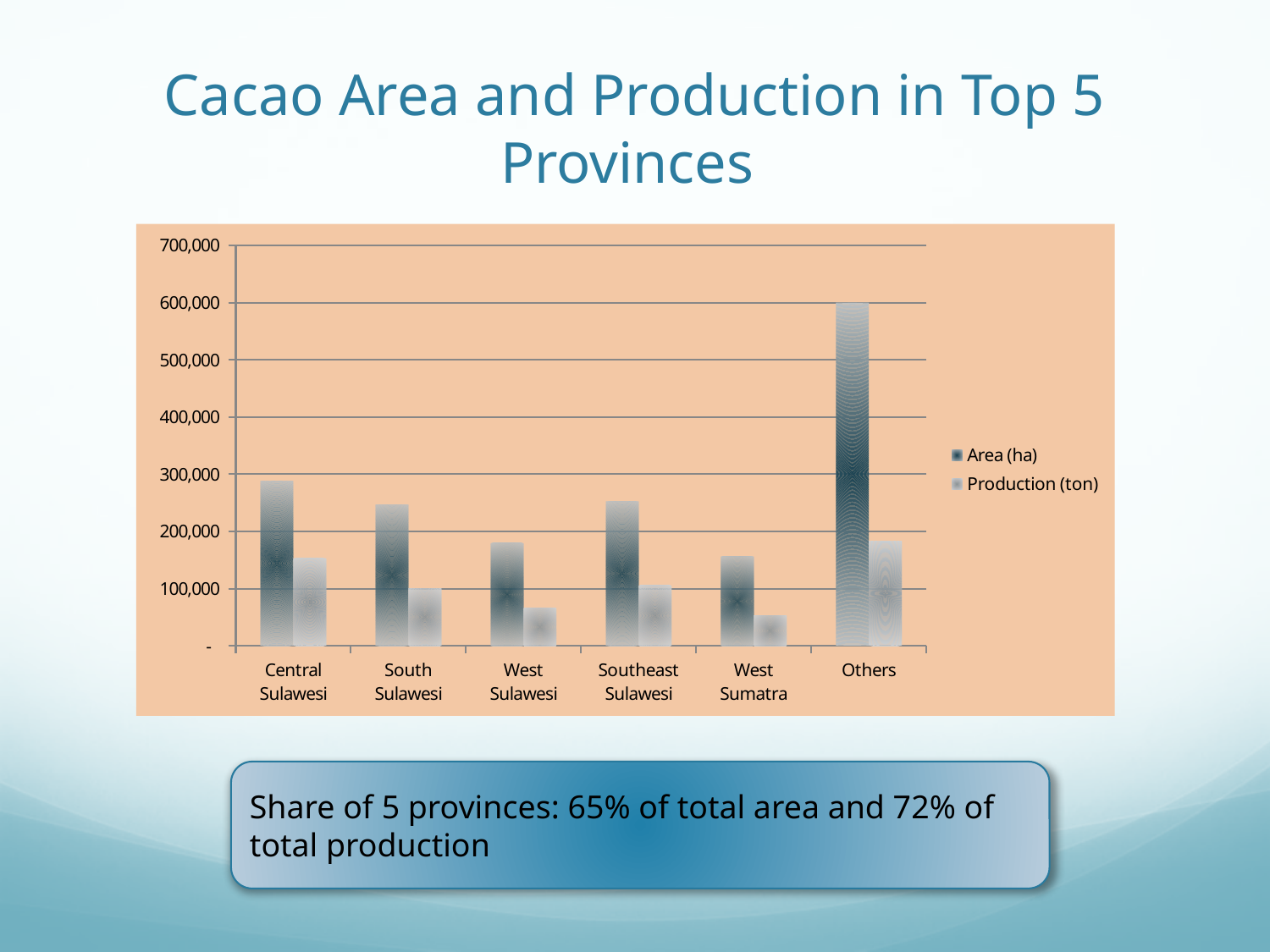
Which category has the highest Area (ha) value? Others What kind of chart is shown on the slide? Bar chart Among the five named provinces (excluding Others), which has the highest Area (ha)? Central Sulawesi How many categories are shown along the x axis of the chart? 6 Is the Production (ton) value for West Sulawesi greater or less than 100,000? less Is the Area (ha) value for Others greater or less than 500,000? greater Which is larger, the Area (ha) for Central Sulawesi or the Area (ha) for South Sulawesi? Central Sulawesi What are the two series listed in the chart's legend? Area (ha) and Production (ton) Is the Area (ha) value for Central Sulawesi greater or less than 200,000? greater Which category has the lowest Area (ha) value? West Sumatra Which category has the lowest Production (ton) value? West Sumatra How many series does the chart's legend list? 2